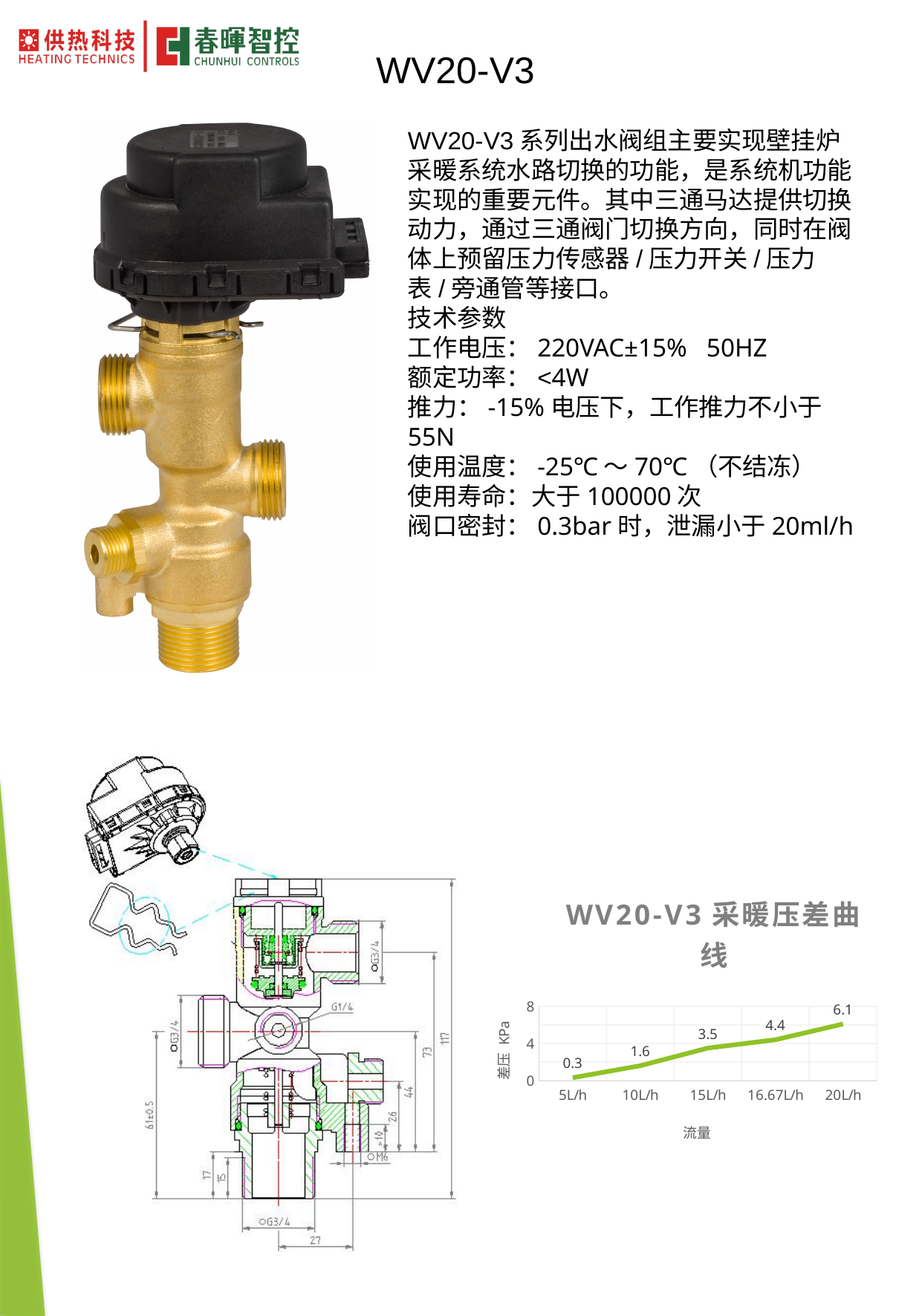
What type of chart is shown on the slide? line chart What is the 差压 value at a flow rate of 5L/h? 0.3 Does the 差压 rise or fall as the flow rate increases along the x axis? rise What is the difference in 差压 between 20L/h and 5L/h? 5.8 What is the 差压 value at a flow rate of 16.67L/h? 4.4 How many flow rate points are plotted on the chart? 5 At which flow rate is the 差压 lowest? 5L/h What is the 差压 value at a flow rate of 20L/h? 6.1 What is the 差压 value at a flow rate of 15L/h? 3.5 What is the title of the chart on the slide? WV20-V3 采暖压差曲线 What is the 差压 value at a flow rate of 10L/h? 1.6 At which flow rate is the 差压 highest? 20L/h